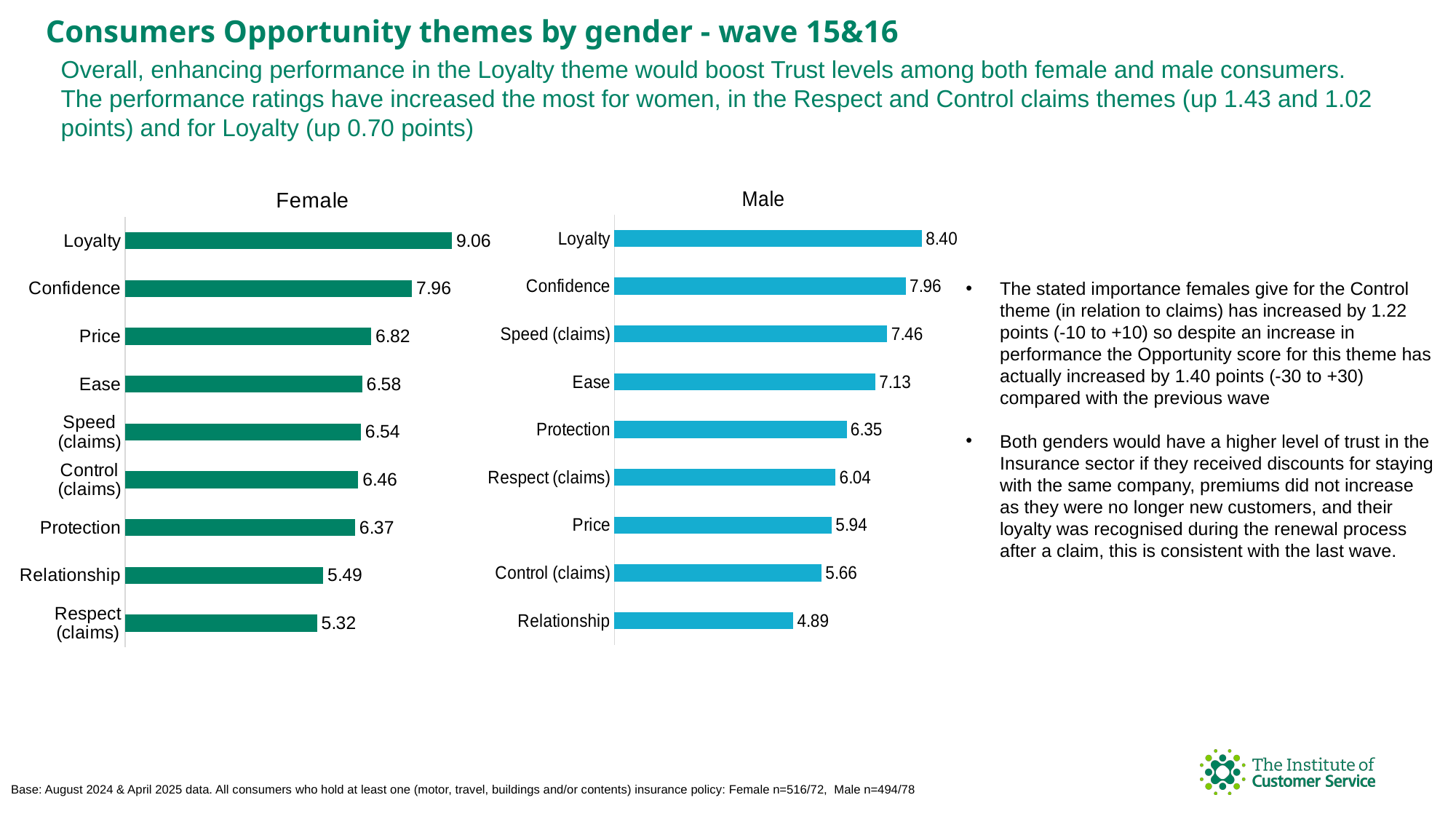
Is the value for Price larger in the Female chart or the Male chart? Female In the Male chart, which theme has the highest value? Loyalty In the Female chart, which theme has the lowest value? Respect (claims) In the Male chart, what is the difference between Loyalty and Relationship? 3.51 In the Female chart, what is the value for Loyalty? 9.06 In the Male chart, which is larger, Ease or Protection? Ease In the Male chart, what is the value for Speed (claims)? 7.46 In the Female chart, what is the difference between Loyalty and Confidence? 1.10 What kind of chart is the Male chart? Bar chart In the Male chart, what is the value for Relationship? 4.89 How many themes are shown in the Female chart? 9 What is the title of the chart on the left? Female